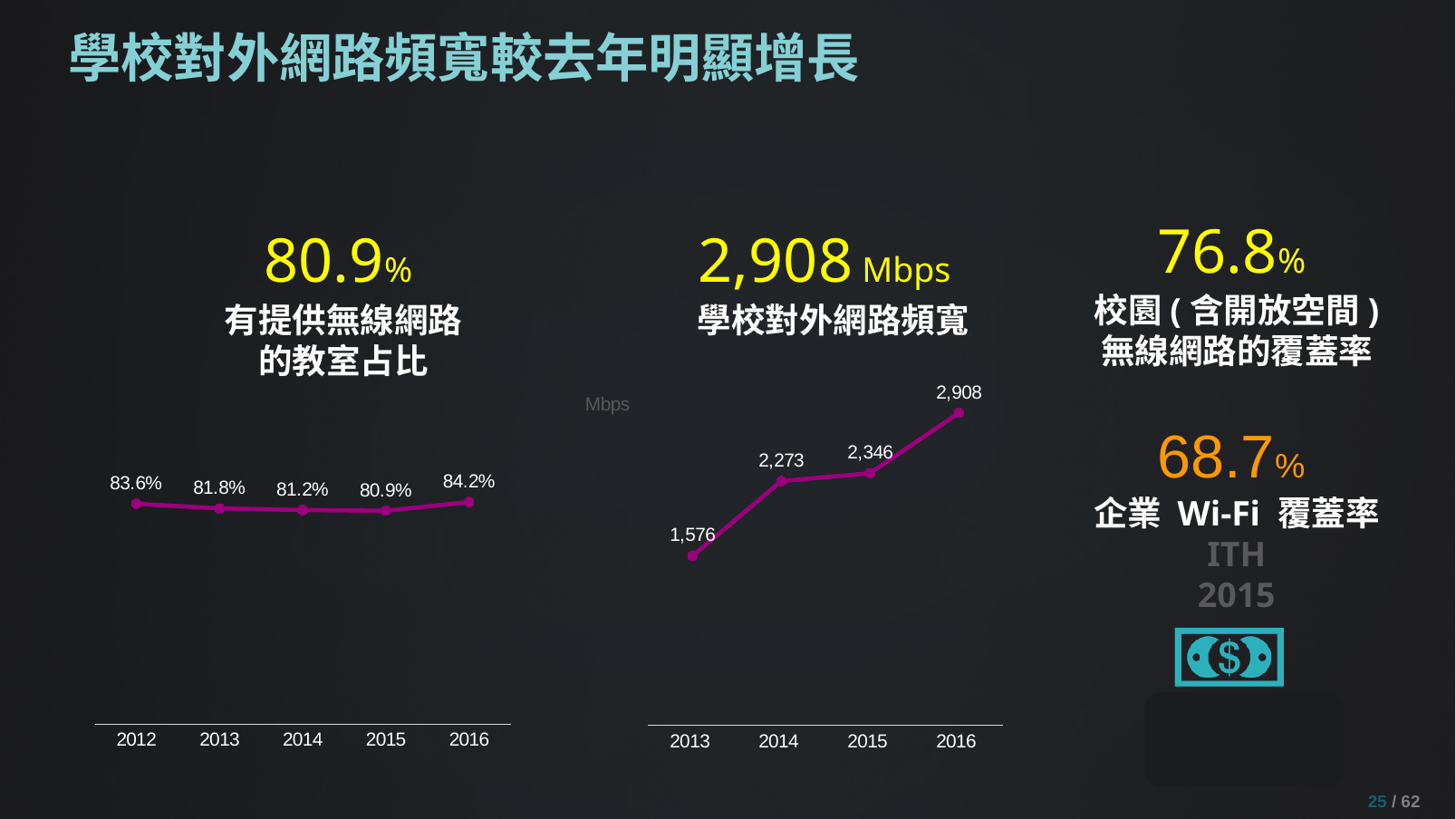
In the left chart (有提供無線網路的教室占比), which year has the lowest value? 2015 In the left chart (有提供無線網路的教室占比), what is the value for 2014? 81.2% In the right chart (學校對外網路頻寬), what is the difference between the 2016 value and the 2015 value? 562 In the right chart (學校對外網路頻寬), what is the value for 2013? 1,576 In the right chart (學校對外網路頻寬), what is the value for 2014? 2,273 In the left chart (有提供無線網路的教室占比), what is the difference between the 2016 value and the 2015 value? 3.3% In the left chart (有提供無線網路的教室占比), which year has the highest value? 2016 In the left chart (有提供無線網路的教室占比), how many years are plotted? 5 In the right chart (學校對外網路頻寬), do the values rise or fall from 2013 to 2016? rise In the right chart (學校對外網路頻寬), how many data points are plotted? 4 What kind of chart is the right chart (學校對外網路頻寬)? line chart In the right chart (學校對外網路頻寬), which year has the highest value? 2016